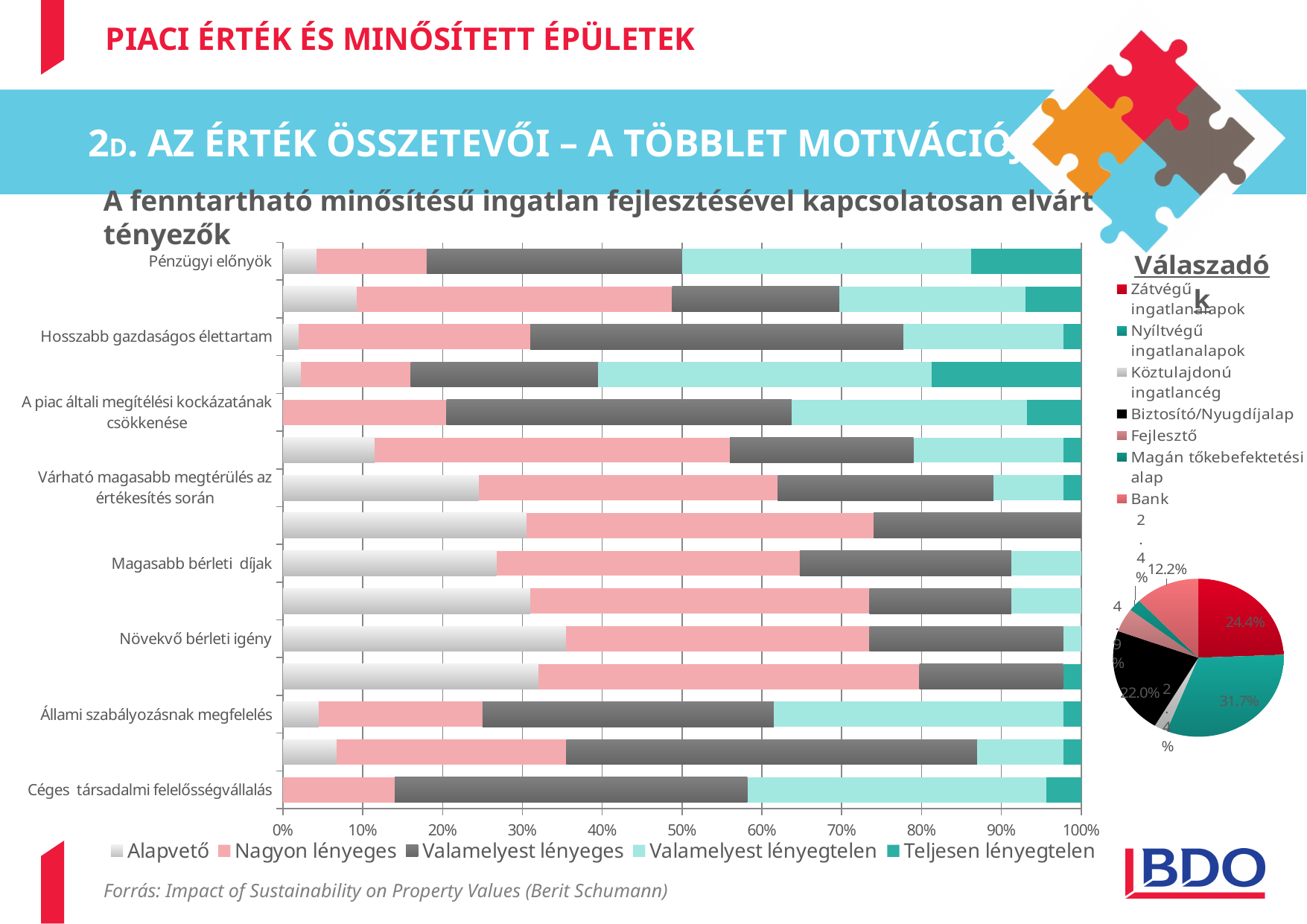
What kind of chart is the small chart titled 'Válaszadók' on the right? Pie chart In the 'Válaszadók' pie chart, what share is shown for Biztosító/Nyugdíjalap? 22.0% In the 'Válaszadók' pie chart, what share is shown for Nyíltvégű ingatlanalapok? 31.7% In the 'Válaszadók' pie chart, which respondent group has the largest slice? Nyíltvégű ingatlanalapok In the 'Válaszadók' pie chart, what is the difference between the Nyíltvégű ingatlanalapok share and the Zátvégű ingatlanalapok share? 7.3% In the 'Válaszadók' pie chart, how many entries does the legend list? 7 In the bar chart, is the 'Alapvető' segment for 'Növekvő bérleti igény' greater or less than 30%? greater In the bar chart, how many series does the legend list? 5 In the 'Válaszadók' pie chart, which is larger: the Zátvégű ingatlanalapok slice or the Biztosító/Nyugdíjalap slice? Zátvégű ingatlanalapok In the 'Válaszadók' pie chart, what share is shown for Zátvégű ingatlanalapok? 24.4% In the bar chart, is the 'Alapvető' segment for 'Pénzügyi előnyök' greater or less than 10%? less What kind of chart is the large chart on the left of the slide? Stacked bar chart